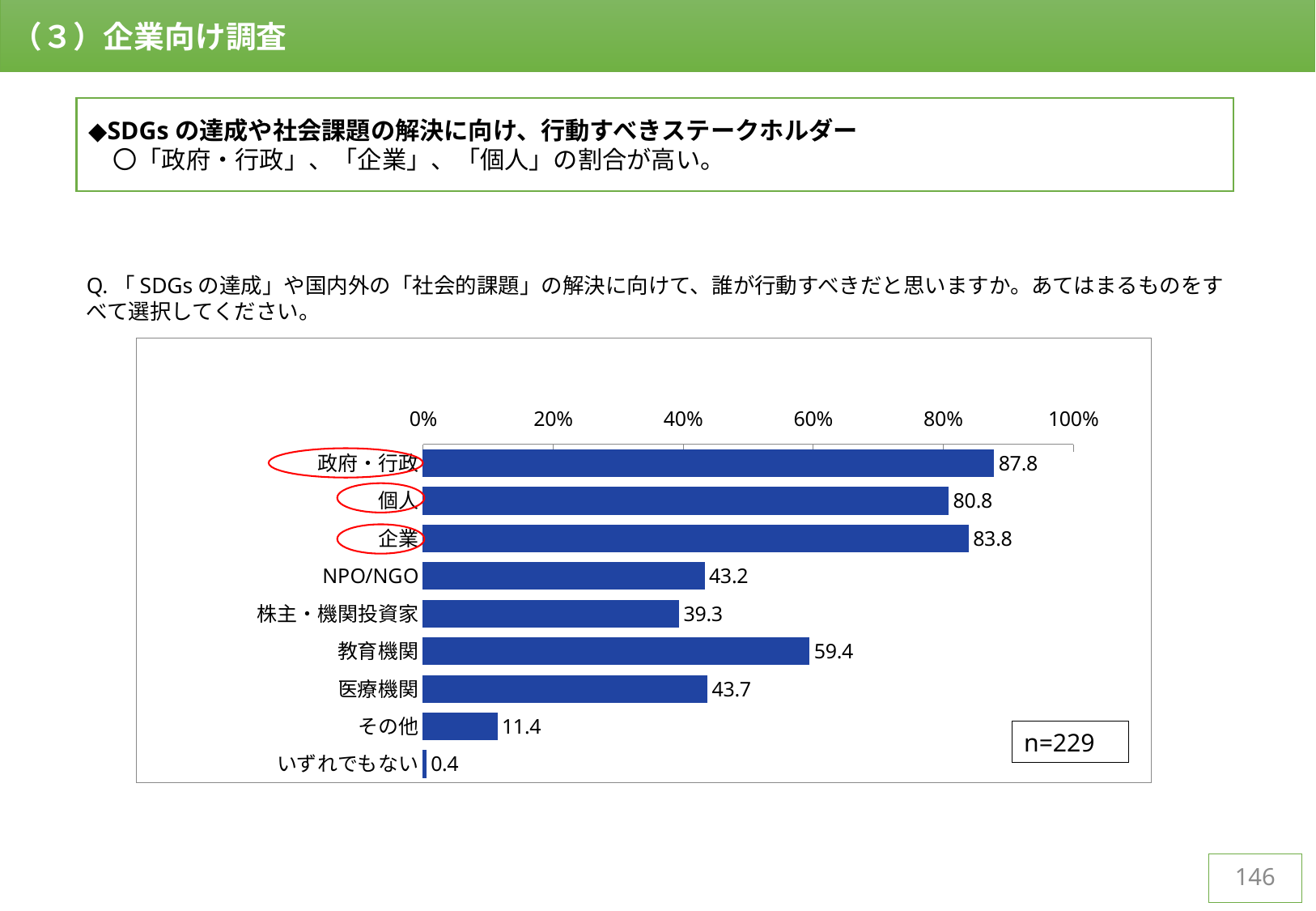
Is the value for 医療機関 greater or less than 40%? greater Which is larger, the value for NPO/NGO or the value for 株主・機関投資家? NPO/NGO What kind of chart is shown on the slide? bar chart What is the value for 教育機関? 59.4 What is the difference between the values for 企業 and 個人? 3.0 What is the difference between the values for 政府・行政 and いずれでもない? 87.4 What is the value for その他? 11.4 What is the sample size (n) shown on the chart? n=229 Which category has the lowest value? いずれでもない Which category has the highest value? 政府・行政 How many categories are shown in the chart? 9 What is the value for 政府・行政? 87.8